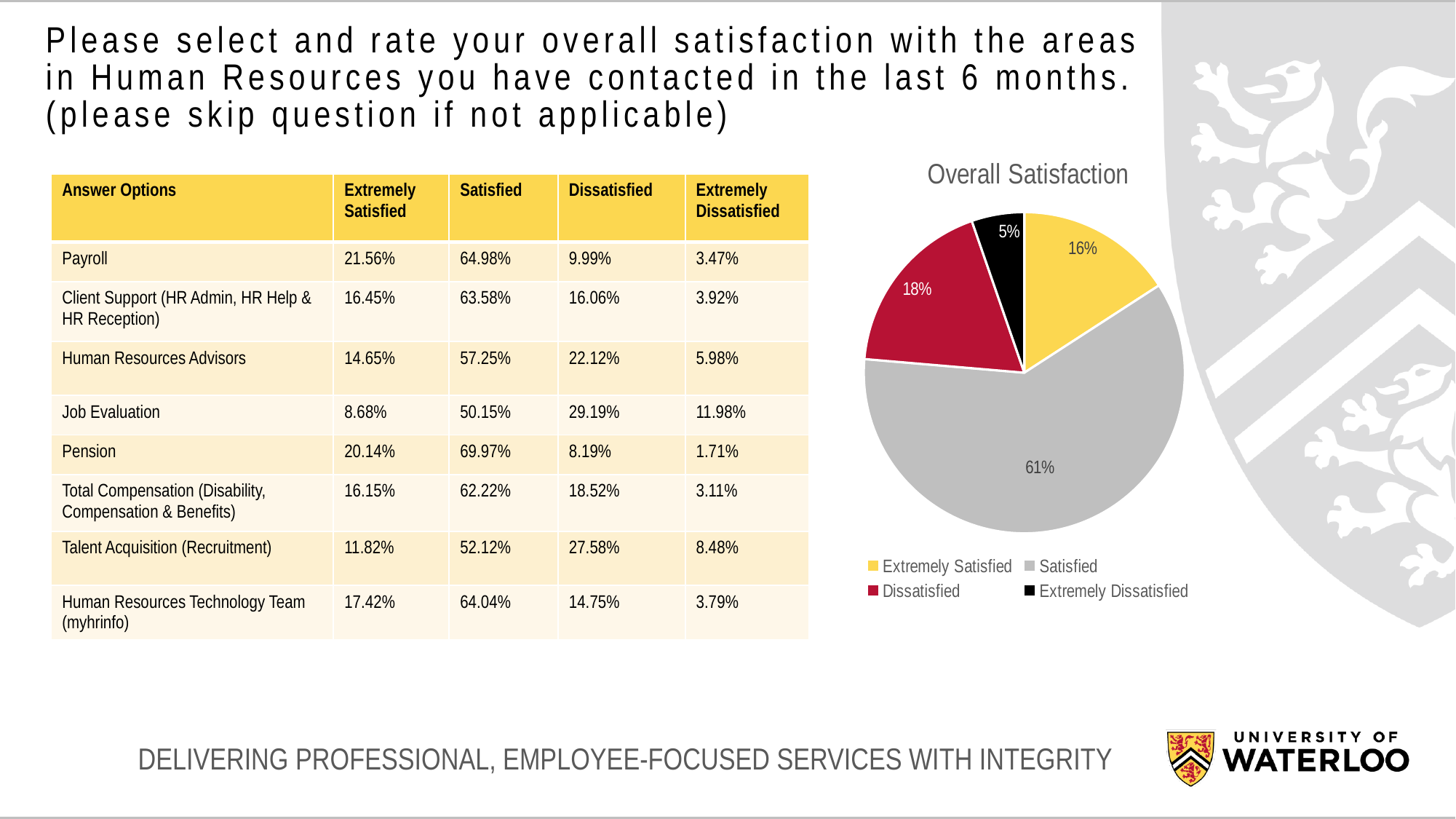
What kind of chart is the Overall Satisfaction chart? pie chart How many slices does the Overall Satisfaction pie chart have? 4 In the Overall Satisfaction pie chart, what is the difference between the Satisfied and Dissatisfied shares? 43% What is the title of the pie chart? Overall Satisfaction In the Overall Satisfaction pie chart, what share is labelled for Dissatisfied? 18% What colour is the Dissatisfied slice in the Overall Satisfaction pie chart? red Which slice of the Overall Satisfaction pie chart is the smallest? Extremely Dissatisfied In the Overall Satisfaction pie chart, what share is labelled for Extremely Satisfied? 16% In the Overall Satisfaction pie chart, what share is labelled for Satisfied? 61% In the Overall Satisfaction pie chart, which is larger: Dissatisfied or Extremely Satisfied? Dissatisfied In the Overall Satisfaction pie chart, what share is labelled for Extremely Dissatisfied? 5% Which slice of the Overall Satisfaction pie chart is the largest? Satisfied